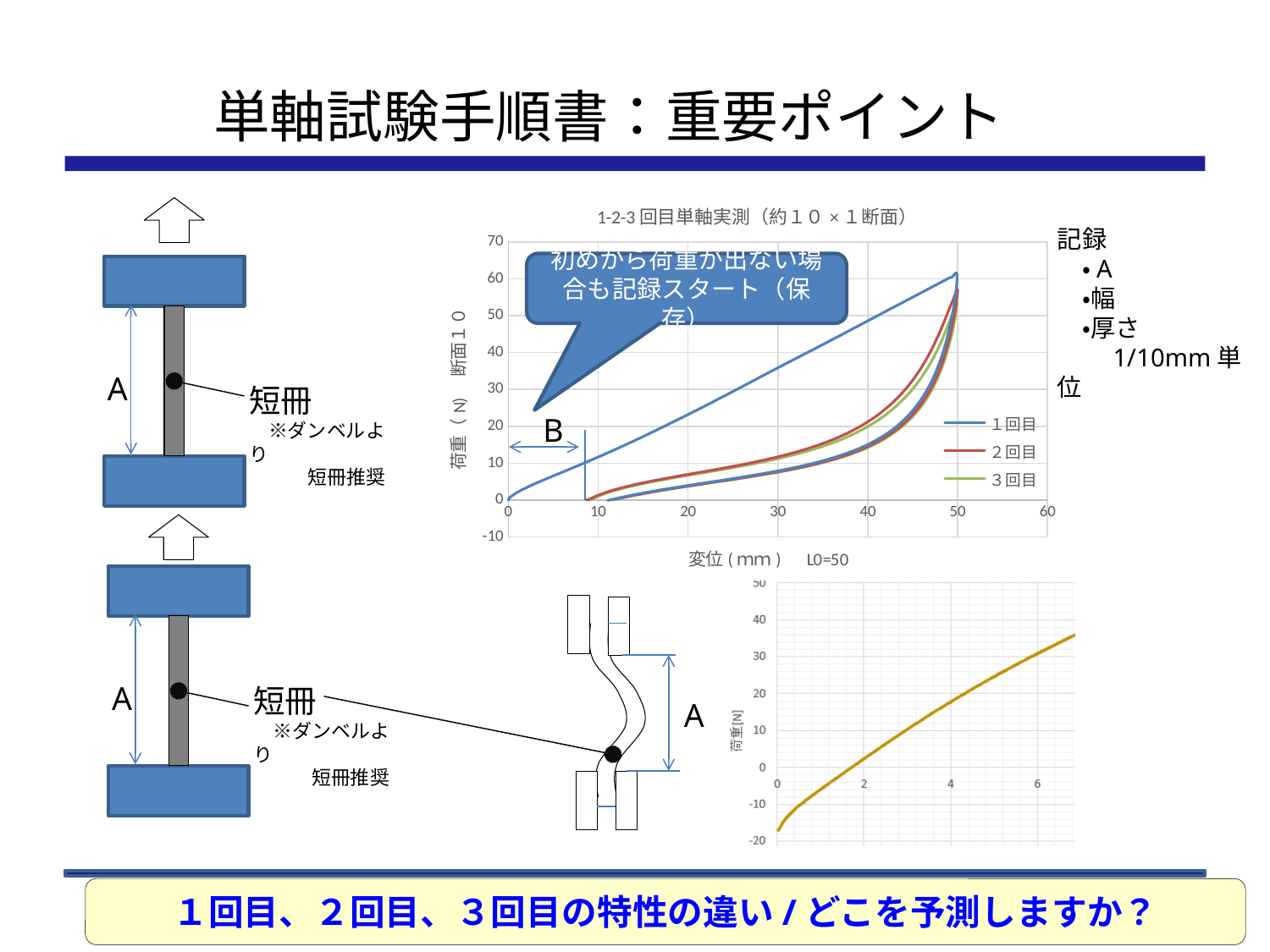
In the chart titled 1-2-3回目単軸実測（約１０×１断面）, is the peak value of the 1回目 series greater or less than 50? greater In the chart at the bottom right of the slide, does the plotted value rise or fall along the x axis? rise How many series does the legend of the chart titled 1-2-3回目単軸実測（約１０×１断面） list? 3 In the chart titled 1-2-3回目単軸実測（約１０×１断面）, what is the x-axis title? 変位（mm） In the chart titled 1-2-3回目単軸実測（約１０×１断面）, does the 1回目 series rise or fall as displacement increases from 0 to 50 mm? rise What kind of chart is the chart at the bottom right of the slide? line chart In the chart at the bottom right of the slide, is the value at x = 0 greater or less than 0? less In the chart titled 1-2-3回目単軸実測（約１０×１断面）, at a displacement of 30 mm, which series has the larger load, 1回目 or 2回目? 1回目 What kind of chart is the chart titled 1-2-3回目単軸実測（約１０×１断面）? line chart In the chart titled 1-2-3回目単軸実測（約１０×１断面）, which series reaches the highest load at a displacement of 50 mm? 1回目 In the chart titled 1-2-3回目単軸実測（約１０×１断面）, what are the three legend entries? 1回目, 2回目, 3回目